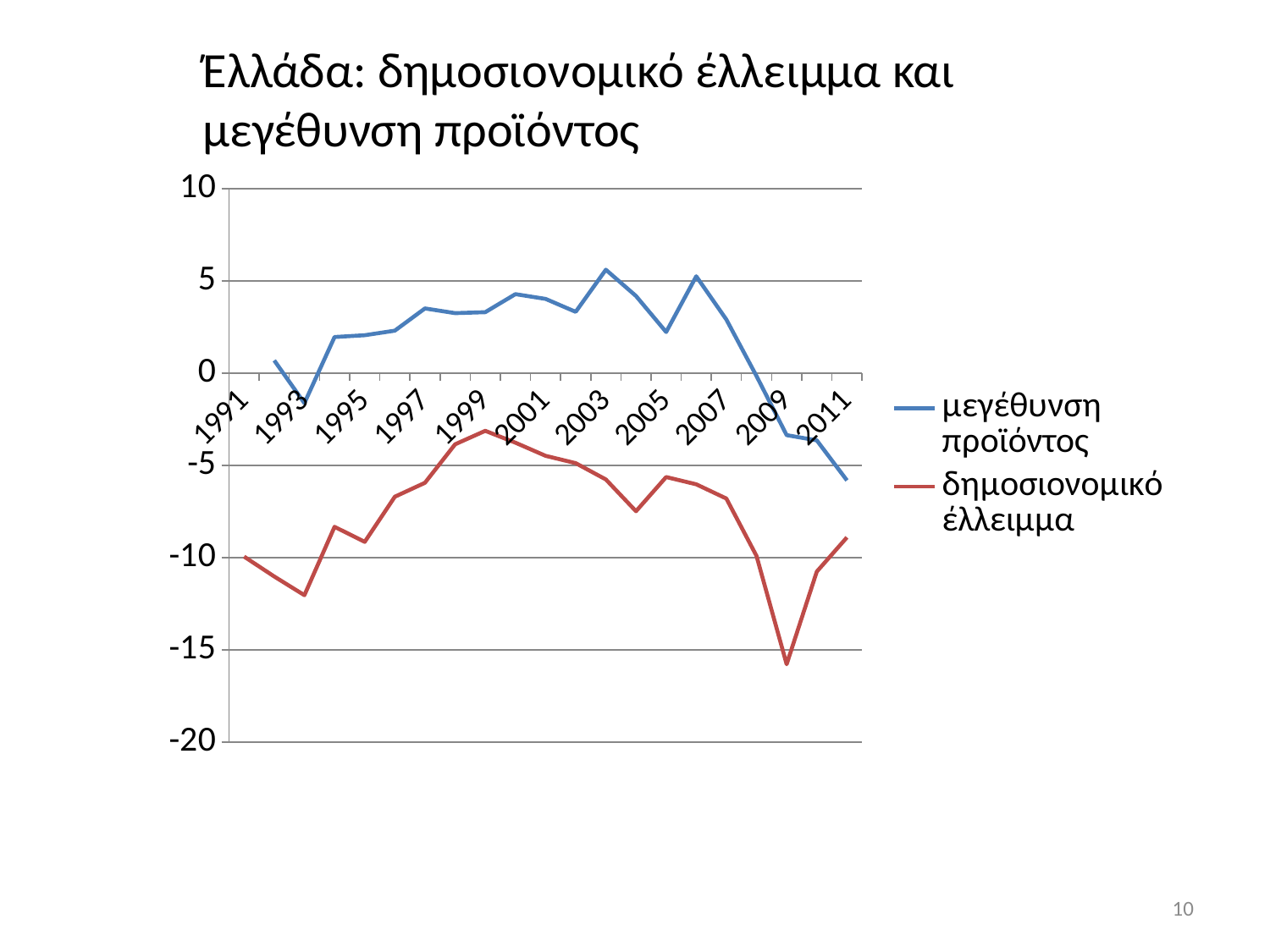
Which is larger, the δημοσιονομικό έλλειμμα value in 1991 or in 1999? 1999 How many series does the legend list? 2 What kind of chart is shown on the slide? line chart In which year does the μεγέθυνση προϊόντος series reach its lowest value? 2011 Is the value of μεγέθυνση προϊόντος in 2011 greater or less than -5? less Which series is drawn in red? δημοσιονομικό έλλειμμα Is the value of δημοσιονομικό έλλειμμα in 2009 greater or less than -10? less Does the μεγέθυνση προϊόντος series rise or fall between 2007 and 2011? fall Is the value of δημοσιονομικό έλλειμμα in 1993 greater or less than -10? less What is the highest value shown on the y axis? 10 In which year does the δημοσιονομικό έλλειμμα series reach its lowest value? 2009